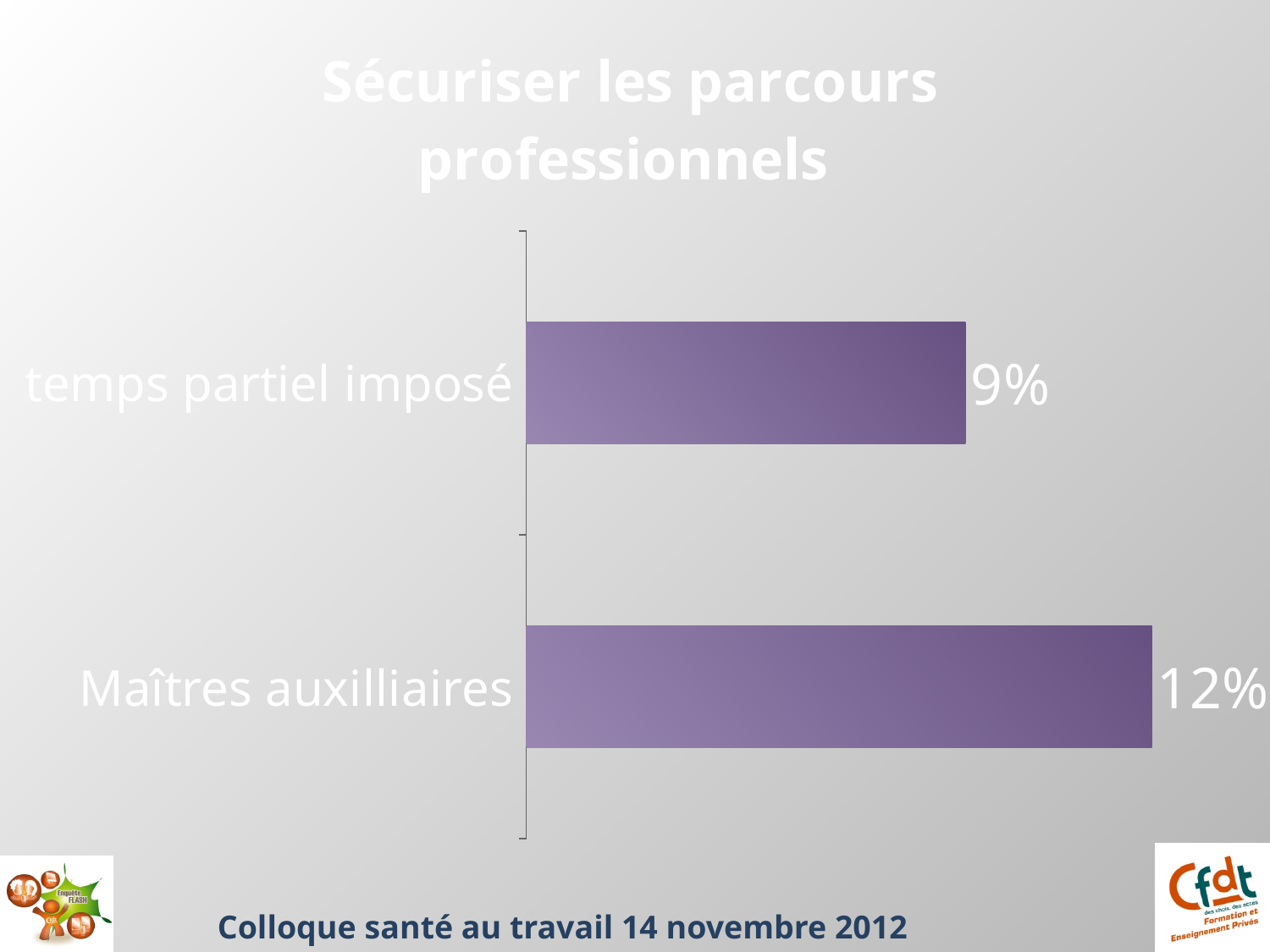
What is the value for "temps partiel imposé"? 9% What is the value for "Maîtres auxilliaires"? 12% Which category has the lowest value? temps partiel imposé What is the title of the chart? Sécuriser les parcours professionnels Which is larger, the value for "Maîtres auxilliaires" or the value for "temps partiel imposé"? Maîtres auxilliaires What is the difference between the values for "Maîtres auxilliaires" and "temps partiel imposé"? 3% What kind of chart is shown on the slide? Bar chart Which category has the highest value? Maîtres auxilliaires What colour are the bars in the chart? Purple How many categories are shown in the chart? 2